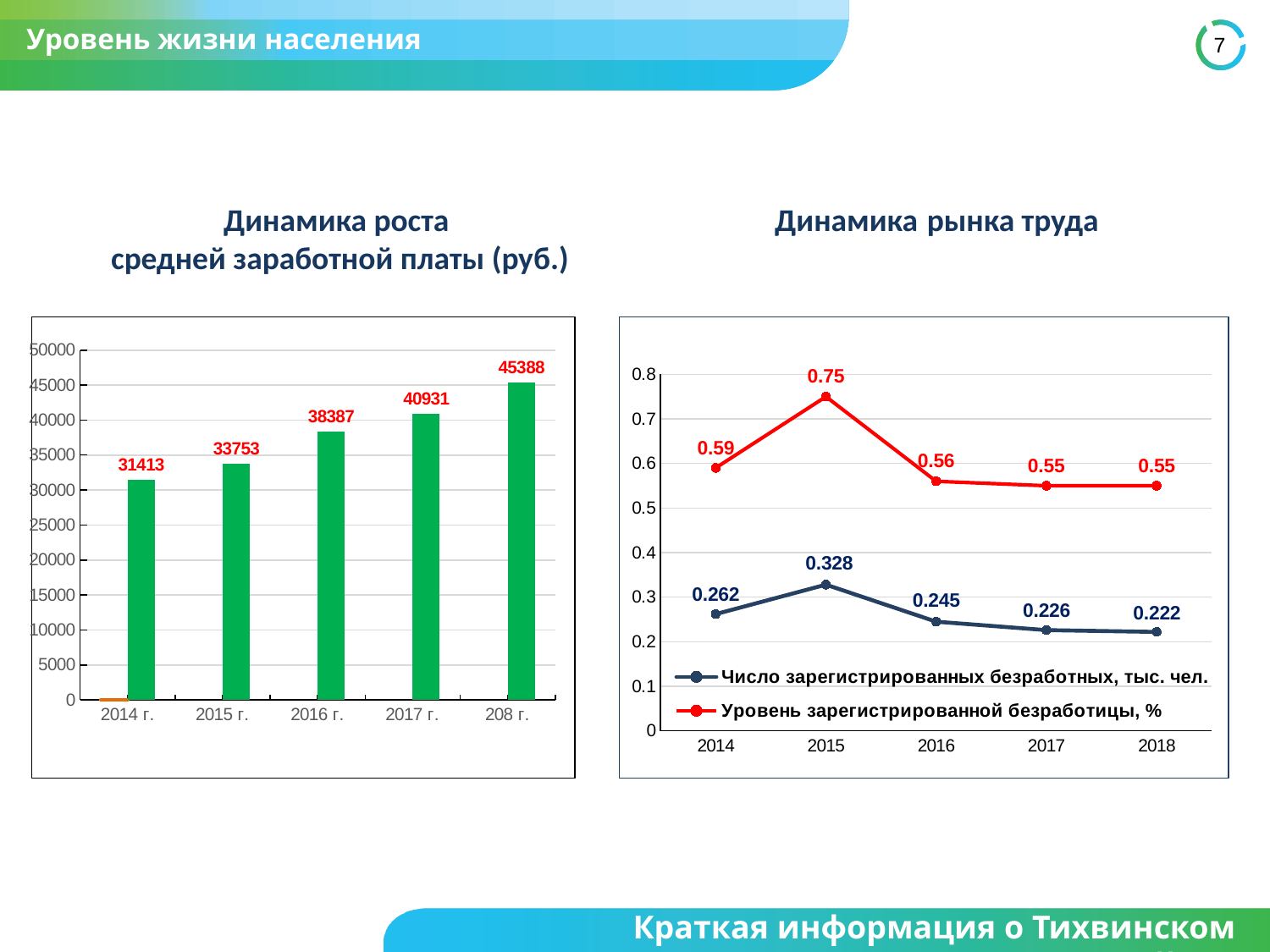
What kind of chart is 'Динамика роста средней заработной платы (руб.)'? bar chart In the chart 'Динамика рынка труда', what is the value of 'Число зарегистрированных безработных, тыс. чел.' for 2018? 0.222 In the chart 'Динамика роста средней заработной платы (руб.)', which year has the lowest value? 2014 г. In the chart 'Динамика роста средней заработной платы (руб.)', what is the value for 2016 г.? 38387 How many series does the legend of the chart 'Динамика рынка труда' list? 2 In the chart 'Динамика роста средней заработной платы (руб.)', do the values rise or fall from 2014 г. to the last year? rise In the chart 'Динамика рынка труда', what is the difference between the 'Уровень зарегистрированной безработицы, %' values for 2015 and 2014? 0.16 In the chart 'Динамика роста средней заработной платы (руб.)', which year has the highest value? 208 г. In the chart 'Динамика рынка труда', what is the value of 'Уровень зарегистрированной безработицы, %' for 2015? 0.75 In the chart 'Динамика рынка труда', which series is drawn in red? Уровень зарегистрированной безработицы, % In the chart 'Динамика роста средней заработной платы (руб.)', what is the difference between the values for 2017 г. and 2015 г.? 7178 In the chart 'Динамика рынка труда', in which year is 'Число зарегистрированных безработных, тыс. чел.' highest? 2015